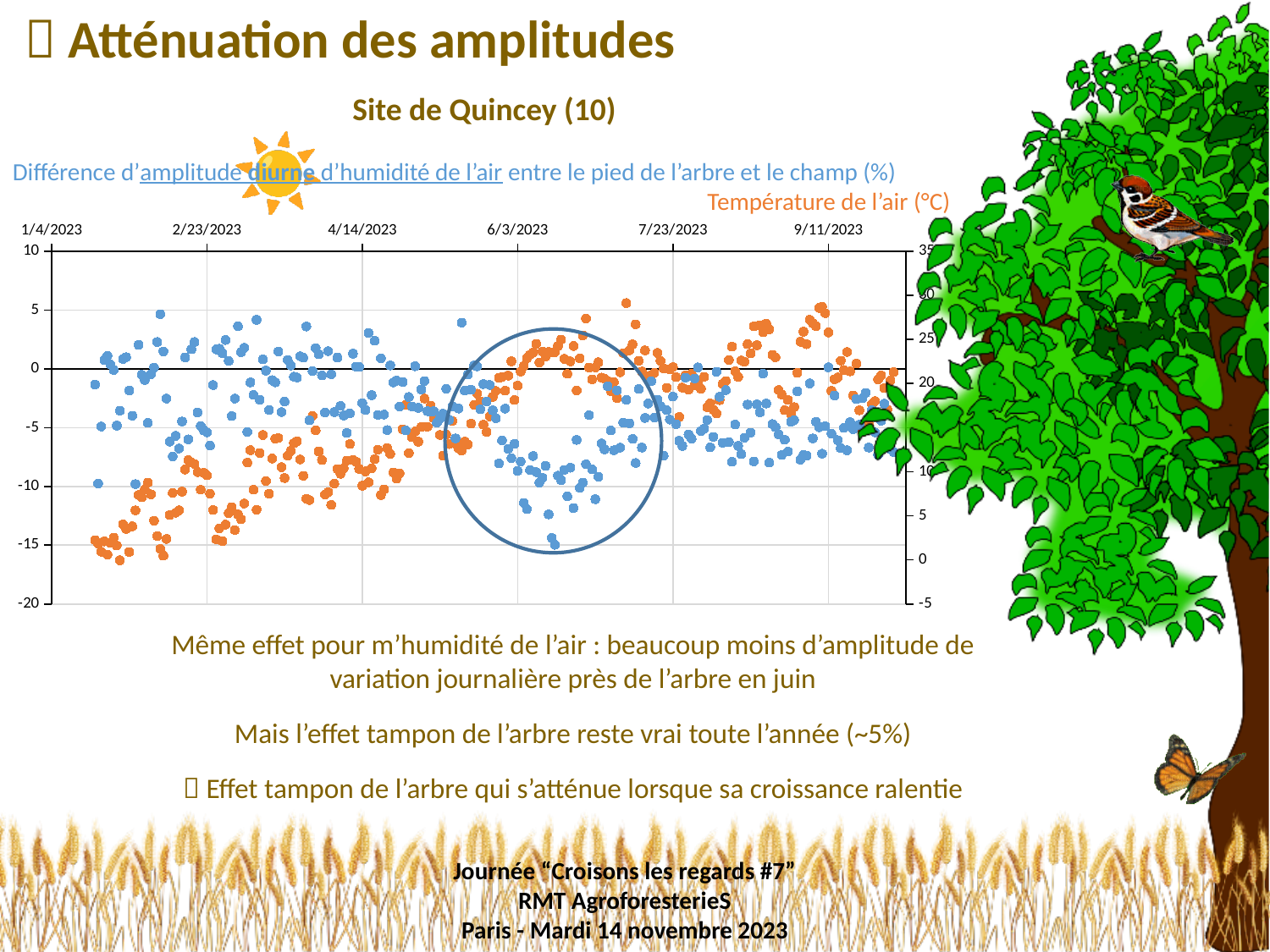
Around 6/3/2023, which series is plotted higher on the chart, the blue or the orange one? orange Are the blue humidity-amplitude values around mid-June 2023 greater or less than -5 on the left axis? less What does the orange series on the chart represent? Température de l'air (°C) How many date labels are shown on the x axis of the chart? 6 How many data series are plotted on the chart? 2 What is the title shown above the chart? Site de Quincey (10) Does the orange temperature series rise or fall from 1/4/2023 to 6/3/2023? rise Between which two x-axis dates does the blue series reach its lowest point? 6/3/2023 and 7/23/2023 Are the orange temperature values in late June 2023 greater or less than 20 on the right axis? greater Are the blue values around 2/23/2023 greater or less than -10 on the left axis? greater What kind of chart is shown on the slide? scatter chart